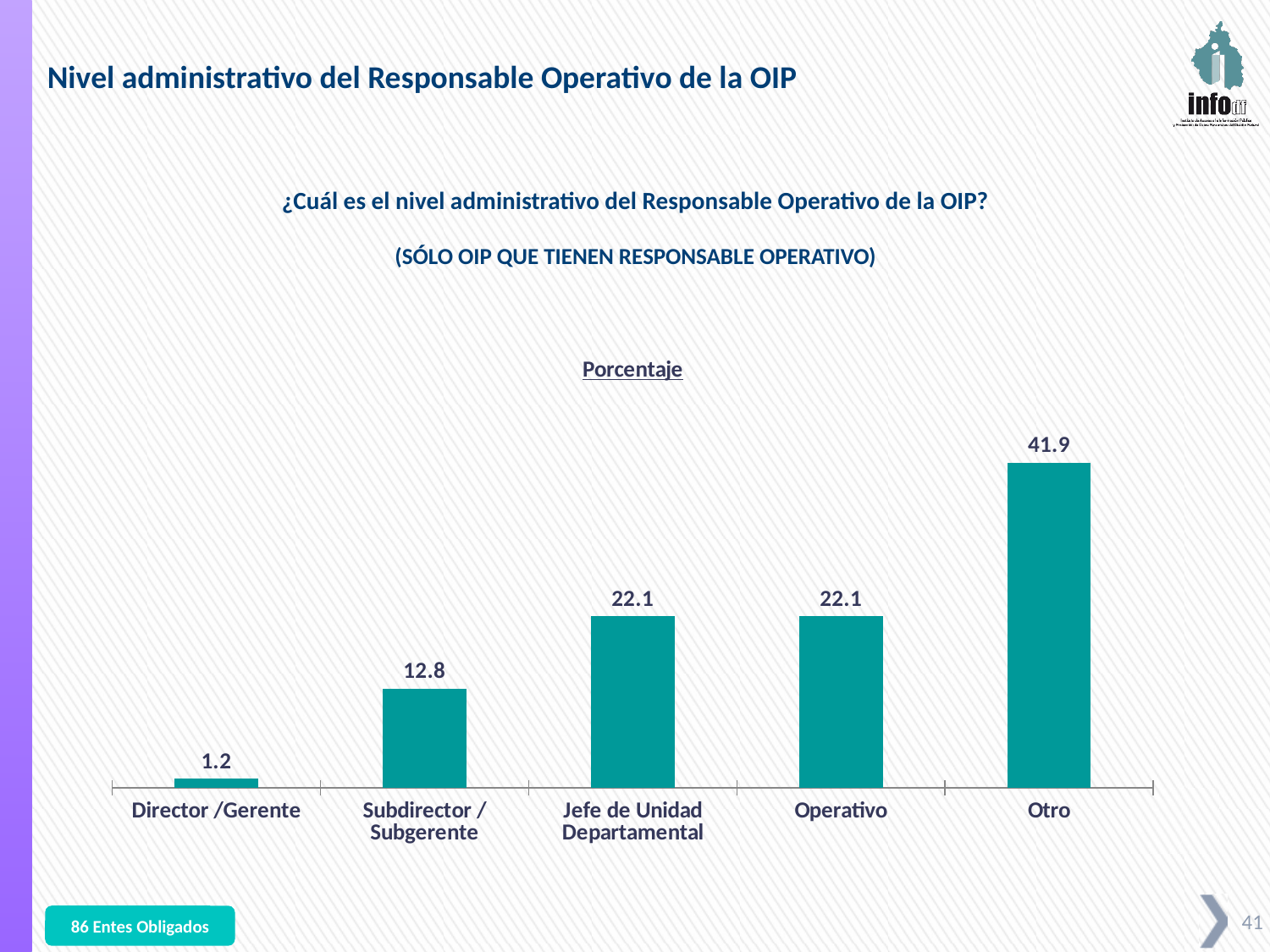
What is the difference between the values for Subdirector / Subgerente and Director /Gerente? 11.6 Which is larger, the value for Subdirector / Subgerente or the value for Jefe de Unidad Departamental? Jefe de Unidad Departamental What kind of chart is shown on the slide? Bar chart What is the value for Otro? 41.9 What is the value for Operativo? 22.1 Which category has the lowest value? Director /Gerente What is the difference between the values for Otro and Operativo? 19.8 What is the title of the chart? Porcentaje How many categories are shown on the x axis? 5 What is the value for Director /Gerente? 1.2 Which category has the highest value? Otro What is the value for Subdirector / Subgerente? 12.8